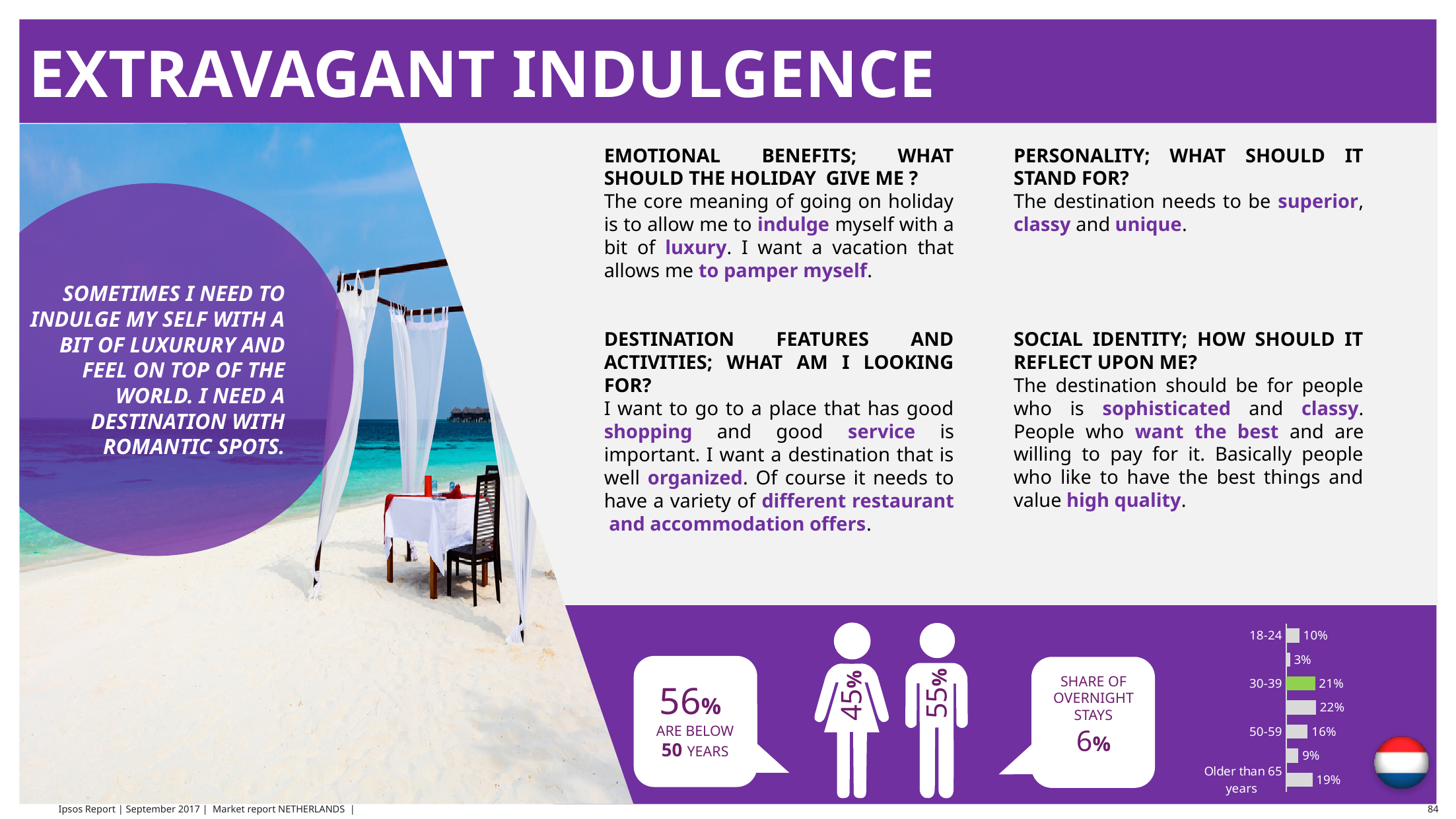
What share of overnight stays is shown in the speech bubble next to the bar chart? 6% What kind of chart is shown at the bottom right of the slide? bar chart In the age-group bar chart, what is the value for Older than 65 years? 19% In the age-group bar chart, what is the value for 50-59? 16% In the age-group bar chart, what is the value for 30-39? 21% In the age-group bar chart, which labeled age group has its bar highlighted in green? 30-39 In the age-group bar chart, what is the value for 18-24? 10% How many bars are plotted in the age-group bar chart? 7 In the age-group bar chart, which is larger: the value for 18-24 or the value for 30-39? 30-39 In the age-group bar chart, what is the difference between the values for Older than 65 years and 50-59? 3% In the age-group bar chart, what is the difference between the values for 30-39 and 18-24? 11% In the age-group bar chart, which is larger: the value for 50-59 or the value for Older than 65 years? Older than 65 years